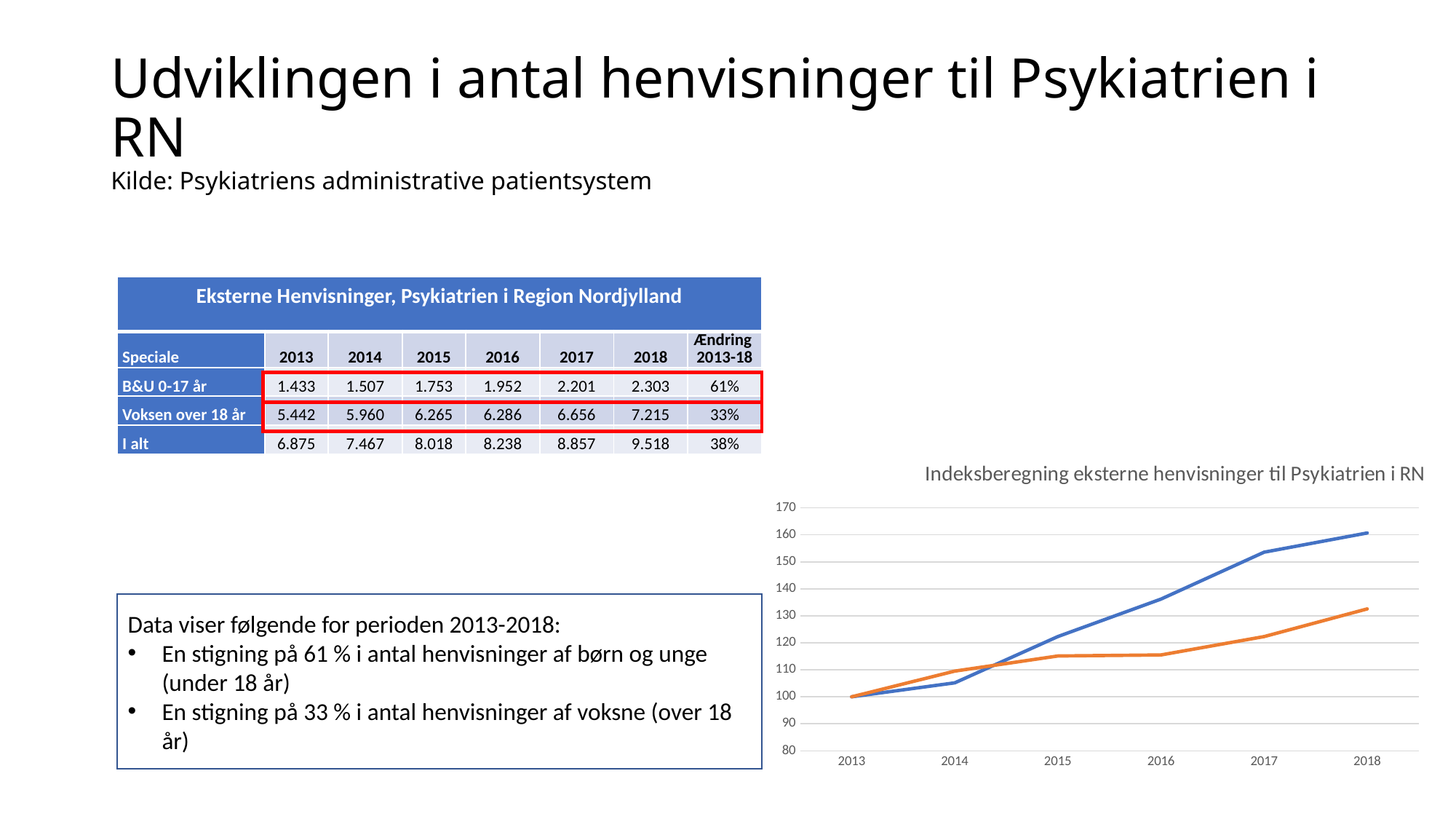
What is the value of the orange line in 2013? 100 Is the value of the orange line in 2018 greater or less than 120? greater What is the title of the chart on the slide? Indeksberegning eksterne henvisninger til Psykiatrien i RN Is the value of the blue line in 2014 greater or less than 110? less How many lines are plotted in the chart? 2 Does the blue line rise or fall from 2013 to 2018? rise How many years are plotted along the x axis of the chart? 6 Is the value of the blue line in 2018 greater or less than 150? greater In which year does the blue line reach its highest value? 2018 In 2018, which line has the higher value, the blue line or the orange line? the blue line What is the value of the blue line in 2013? 100 What kind of chart is shown on the slide? line chart